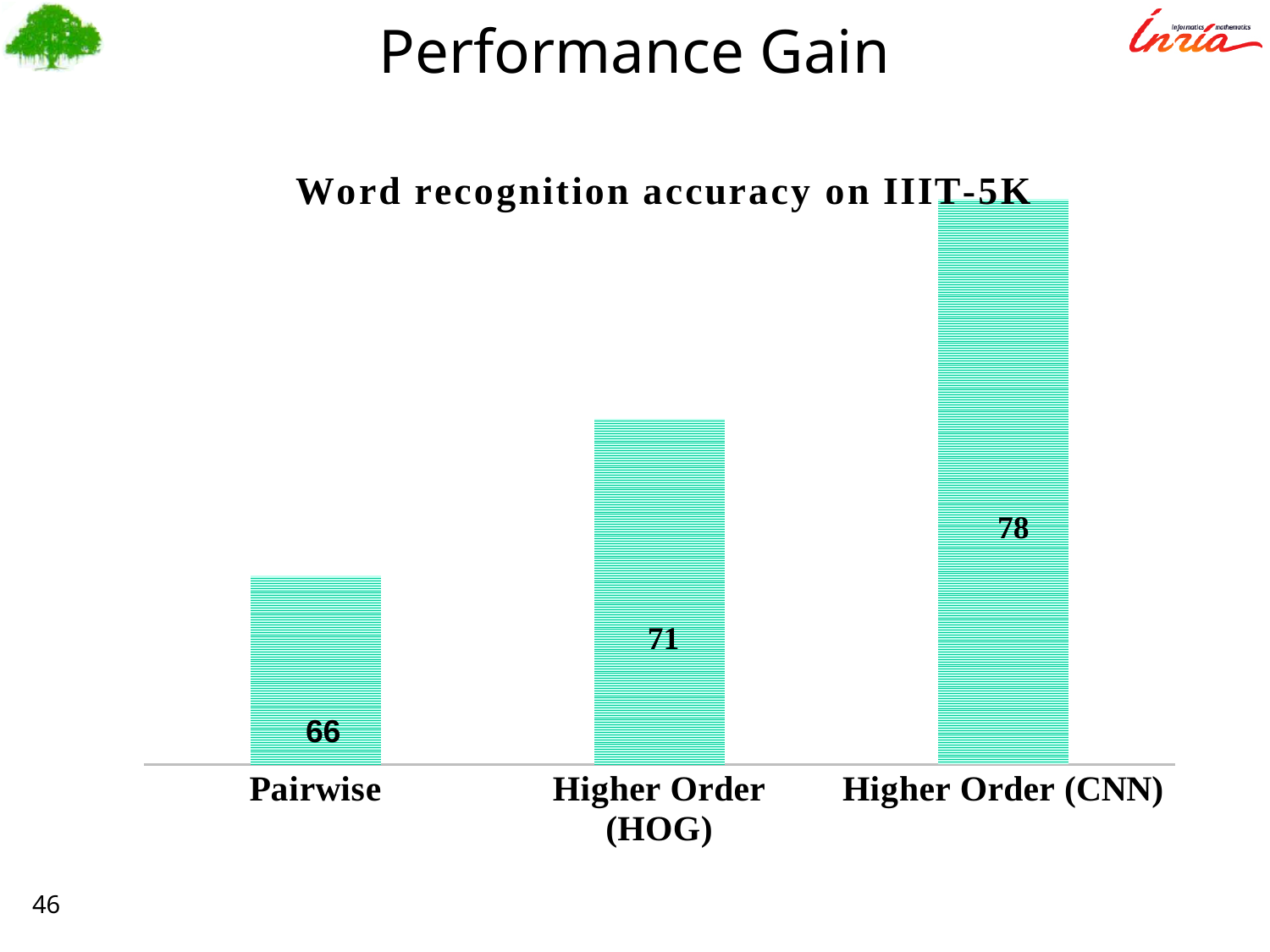
What is the word recognition accuracy for Higher Order (CNN)? 78 What is the word recognition accuracy for Higher Order (HOG)? 71 How many categories are shown in the chart? 3 Which category has the highest word recognition accuracy? Higher Order (CNN) Which category has the lowest word recognition accuracy? Pairwise Do the values rise or fall from left to right across the categories? Rise What is the word recognition accuracy for Pairwise? 66 What is the title of the chart? Word recognition accuracy on IIIT-5K What kind of chart is shown on the slide? Bar chart Which has a higher accuracy, Higher Order (HOG) or Higher Order (CNN)? Higher Order (CNN) What is the difference in accuracy between Higher Order (HOG) and Pairwise? 5 What is the difference in accuracy between Higher Order (CNN) and Pairwise? 12